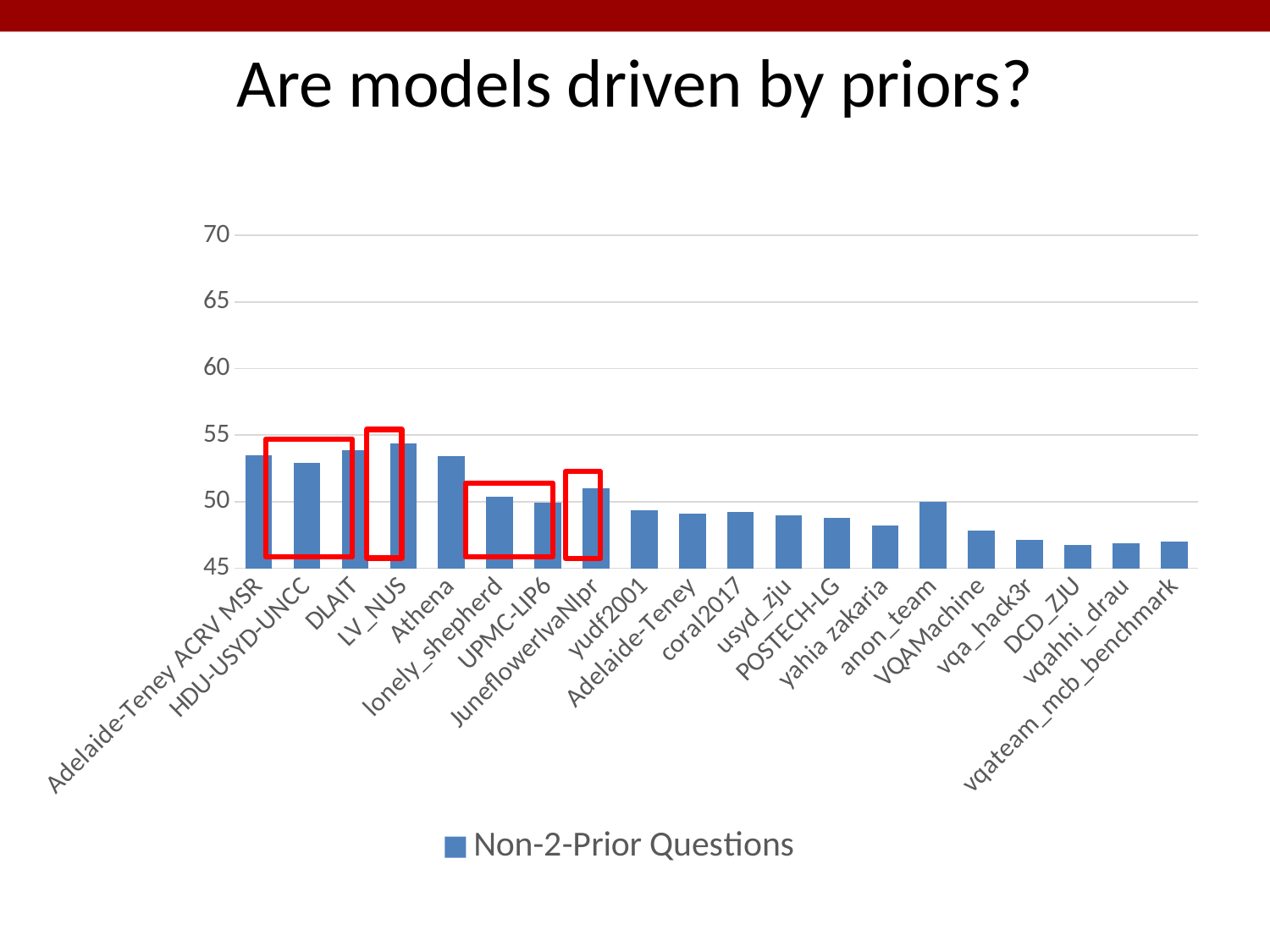
How many categories (teams) are plotted along the x axis? 20 How many series does the legend list? 1 Which category has the highest value? LV_NUS Do the values generally rise or fall moving from left to right along the x axis? fall Is the value for LV_NUS greater or less than 55? less Is the value for VQAMachine greater or less than 50? less What kind of chart is shown on the slide? bar chart What is the name of the series shown in the legend? Non-2-Prior Questions Is the value for Athena greater or less than 50? greater Which is larger, the value for anon_team or the value for VQAMachine? anon_team Which is larger, the value for Athena or the value for yudf2001? Athena